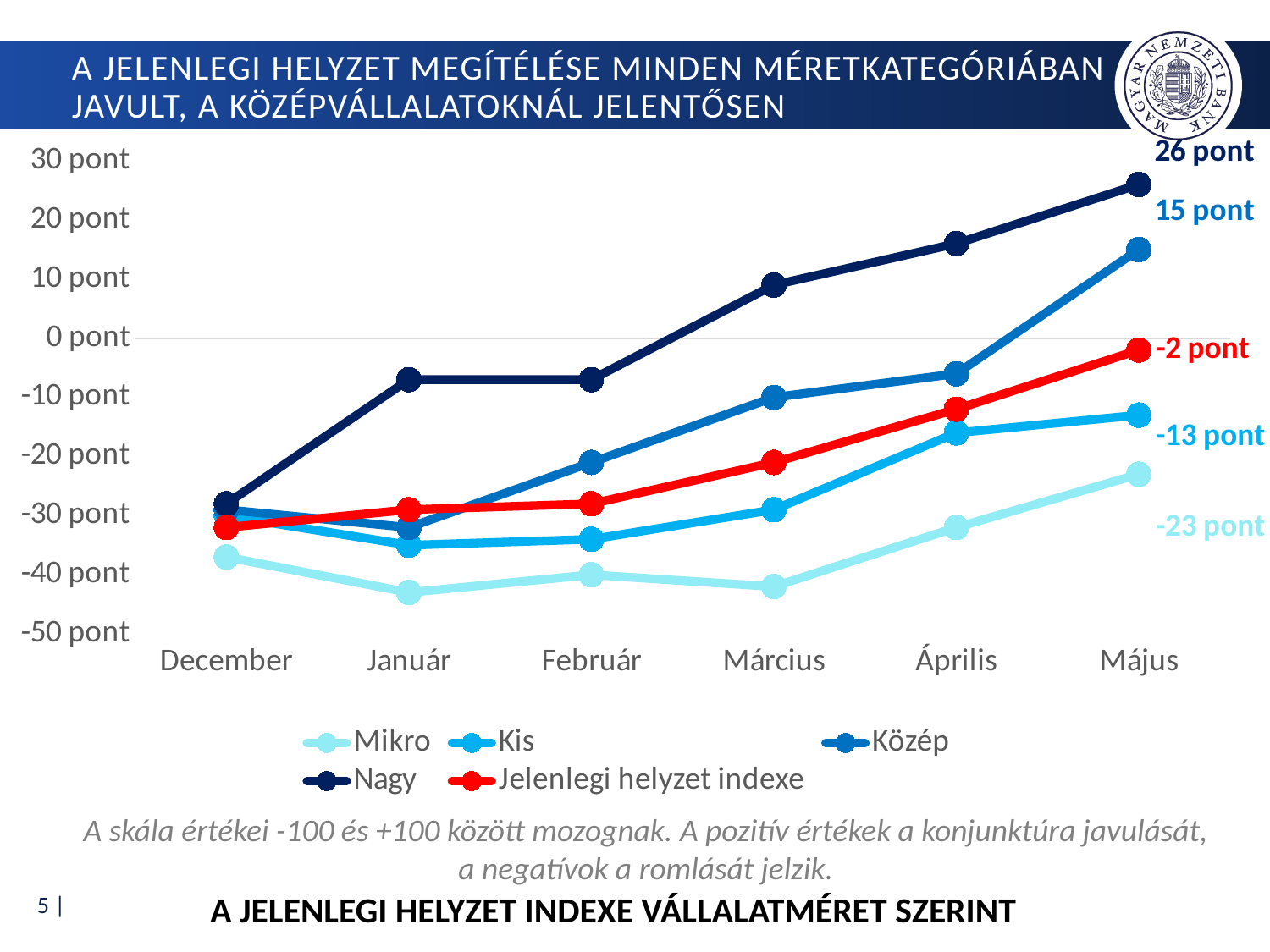
What is the value for Közép in Május? 15 pont What kind of chart is shown on the slide? line chart Which series has the highest value in Május? Nagy What is the value of the Jelenlegi helyzet indexe in Május? -2 pont Which series has the lowest value in Május? Mikro How many series does the legend list? 5 Does the Nagy series rise or fall from December to Május? rise How many months are shown on the x axis? 6 What is the value for Mikro in Május? -23 pont What is the value for Nagy in Május? 26 pont What is the difference between the Nagy and Közép values in Május? 11 pont Is the value for Mikro in Január greater or less than -40 pont? less